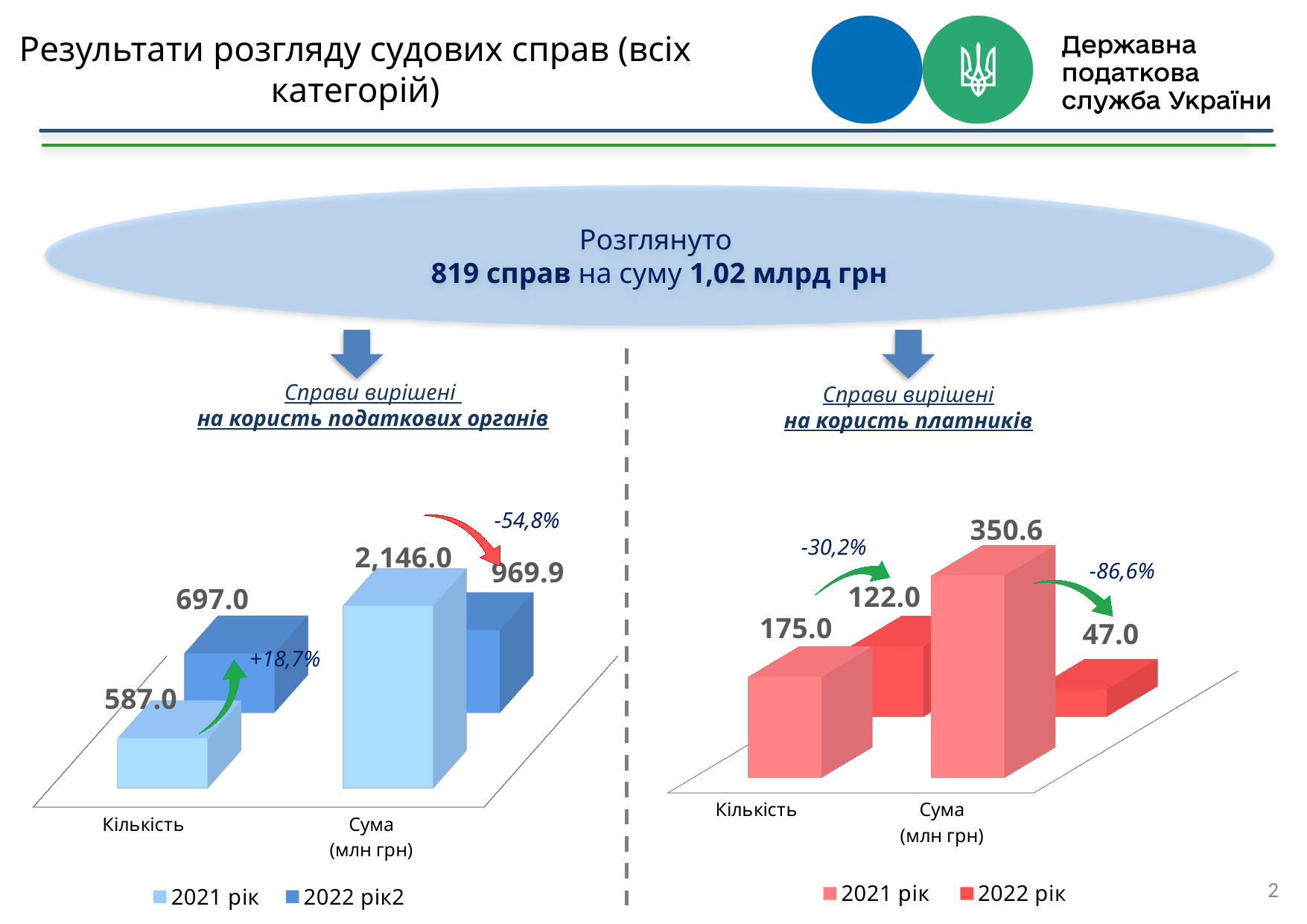
In the left chart (cases decided in favour of tax authorities), what is the value for Кількість in 2021 рік? 587.0 In the left chart (cases decided in favour of tax authorities), which bar has the highest value? Сума (млн грн), 2021 рік In the left chart (cases decided in favour of tax authorities), what is the value for Кількість in 2022 рік2? 697.0 What type of chart is used on the left side of the slide (cases decided in favour of tax authorities)? Bar chart In the left chart (cases decided in favour of tax authorities), what is the value for Сума (млн грн) in 2022 рік2? 969.9 In the left chart (cases decided in favour of tax authorities), what is the value for Сума (млн грн) in 2021 рік? 2,146.0 In the left chart (cases decided in favour of tax authorities), what is the difference between the Кількість values for 2022 рік2 and 2021 рік? 110.0 In the right chart (cases decided in favour of taxpayers), what is the value for Кількість in 2022 рік? 122.0 In the right chart (cases decided in favour of taxpayers), which year has the larger Кількість value, 2021 рік or 2022 рік? 2021 рік How many series does the legend of the right chart (cases decided in favour of taxpayers) list? 2 In the right chart (cases decided in favour of taxpayers), what is the value for Сума (млн грн) in 2021 рік? 350.6 In the right chart (cases decided in favour of taxpayers), what is the difference between the Сума values for 2021 рік and 2022 рік? 303.6